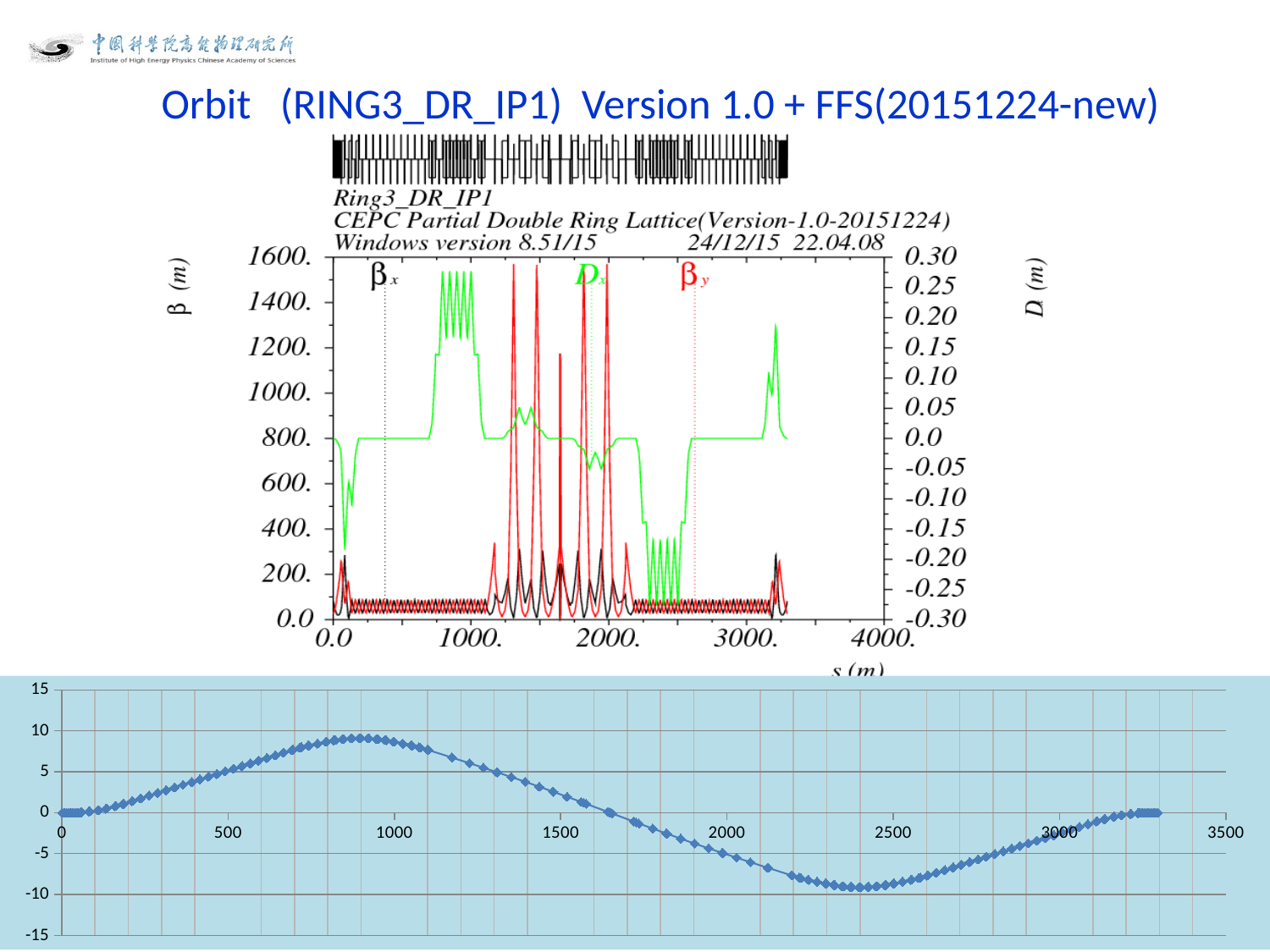
In the bottom chart, do the values rise or fall as s goes from 0 to 800? rise In the top chart, what is the highest tick value on the left-hand β (m) axis? 1600. In the top chart, what is the highest tick value on the right-hand D (m) axis? 0.30 What kind of chart is the bottom chart on the slide? line chart In the bottom chart, what is the maximum value shown on the vertical axis? 15 In the bottom chart, is the value at s = 1500 greater or less than 10? less In the top chart, which curve is drawn in green: βx, Dx or βy? Dx In the bottom chart, is the value at s = 2400 greater or less than -5? less In the bottom chart, is the value at s = 900 greater or less than 5? greater In the bottom chart, is the value at s = 900 larger or smaller than the value at s = 2400? larger In the bottom chart, do the values rise or fall as s goes from 1000 to 2000? fall In the top chart, what is the label of the left vertical axis? β (m)